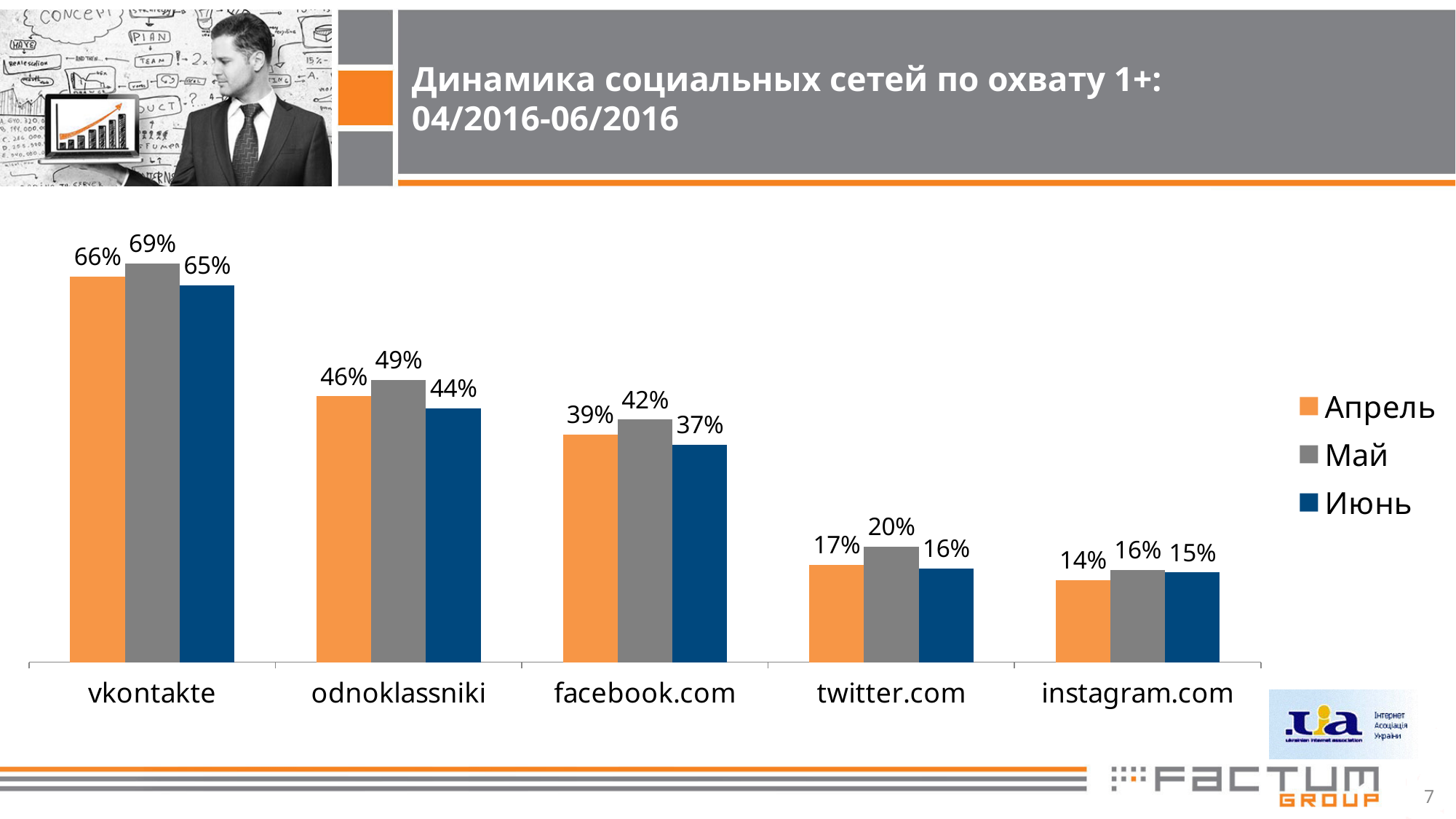
What kind of chart is shown on the slide? bar chart Which colour represents the Май series in the legend? grey How many series does the legend list? 3 What is the value for instagram.com in the Апрель series? 14% What is the value for facebook.com in the Июнь series? 37% Which is larger for twitter.com: the Апрель value or the Июнь value? Апрель What is the value for vkontakte in the Май series? 69% Which category has the highest value in the Май series? vkontakte Do the Июнь values rise or fall from vkontakte to instagram.com along the x axis? fall How many categories are shown on the x axis? 5 Which category has the lowest value in the Апрель series? instagram.com What is the difference between the Май and Июнь values for odnoklassniki? 5%